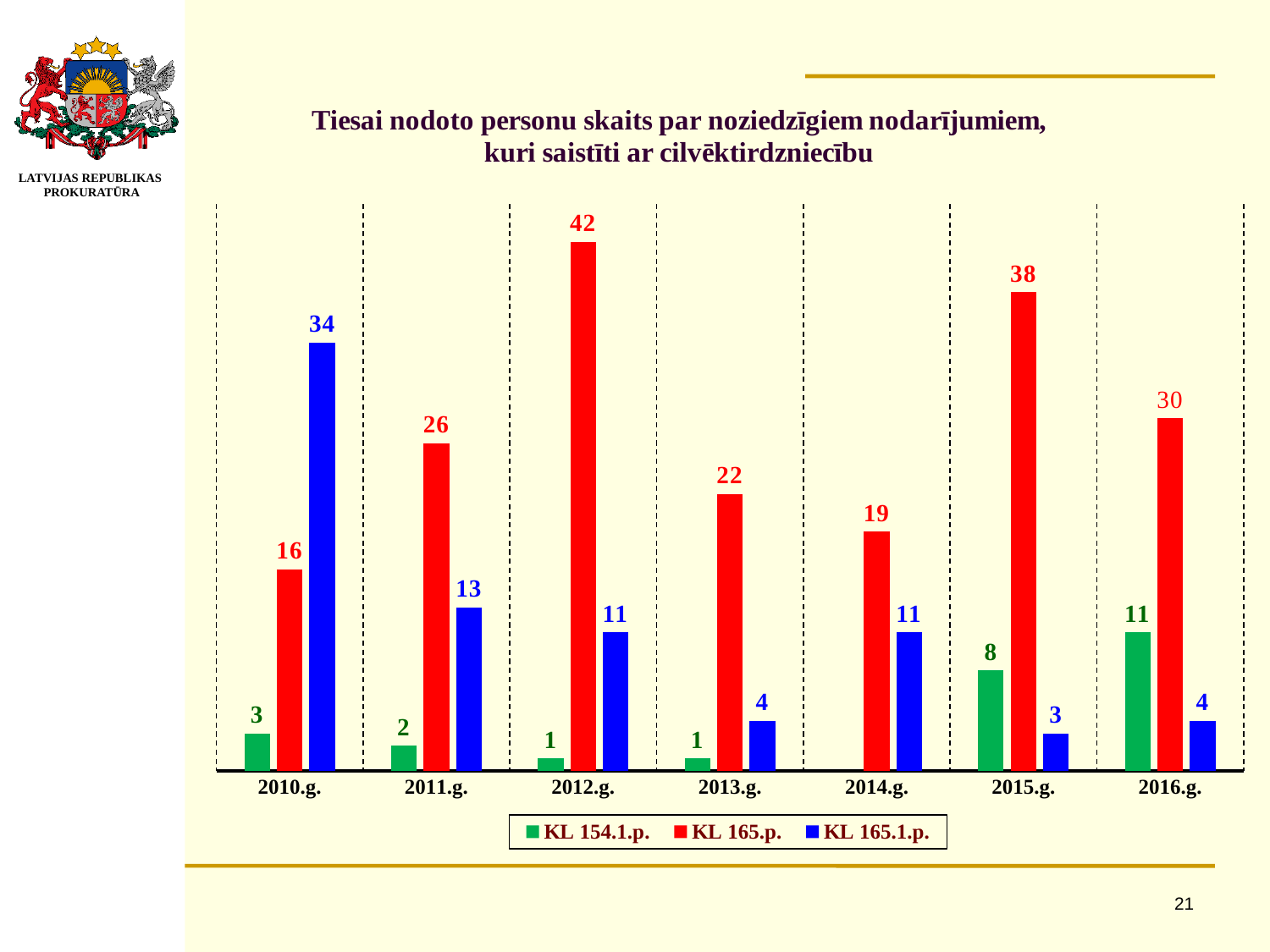
Which is larger in 2010.g., the value for KL 165.p. or the value for KL 165.1.p.? KL 165.1.p. In which year is the value for KL 165.1.p. lowest? 2015.g. What is the value for KL 165.p. in 2012.g.? 42 How many series does the legend list? 3 What is the difference between the KL 165.p. values in 2015.g. and 2016.g.? 8 How many years are shown on the x axis? 7 Which colour represents the KL 154.1.p. series in the legend? Green What is the difference between the KL 165.1.p. values in 2010.g. and 2011.g.? 21 What is the value for KL 165.1.p. in 2010.g.? 34 What kind of chart is shown on the slide? Bar chart In which year is the value for KL 165.p. highest? 2012.g. What is the value for KL 154.1.p. in 2016.g.? 11